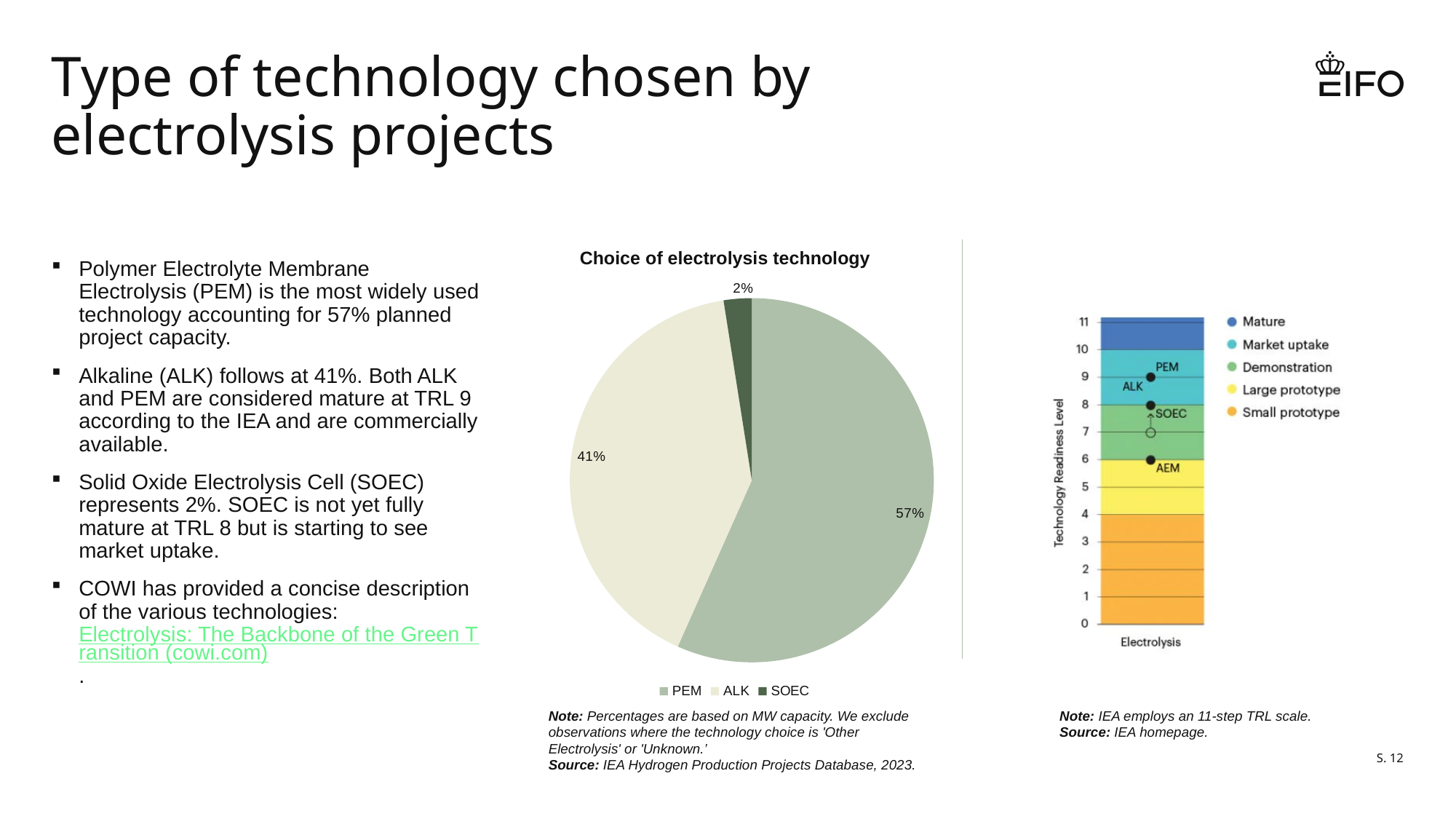
In the 'Choice of electrolysis technology' pie chart, what share does ALK have? 41% In the 'Choice of electrolysis technology' pie chart, which technology has the smallest slice? SOEC In the 'Choice of electrolysis technology' pie chart, what share does SOEC have? 2% In the 'Choice of electrolysis technology' pie chart, what is the combined share of PEM and ALK? 98% What are the legend entries of the 'Choice of electrolysis technology' pie chart, in order? PEM, ALK, SOEC In the 'Choice of electrolysis technology' pie chart, which technology has the largest slice? PEM In the 'Choice of electrolysis technology' pie chart, what share does PEM have? 57% In the Technology Readiness Level figure on the right, at what TRL is AEM plotted? 6 What kind of chart is 'Choice of electrolysis technology'? Pie chart In the 'Choice of electrolysis technology' pie chart, what is the difference in percentage points between PEM and ALK? 16 percentage points How many categories does the 'Choice of electrolysis technology' pie chart show? 3 In the 'Choice of electrolysis technology' pie chart, which is larger, ALK or SOEC? ALK